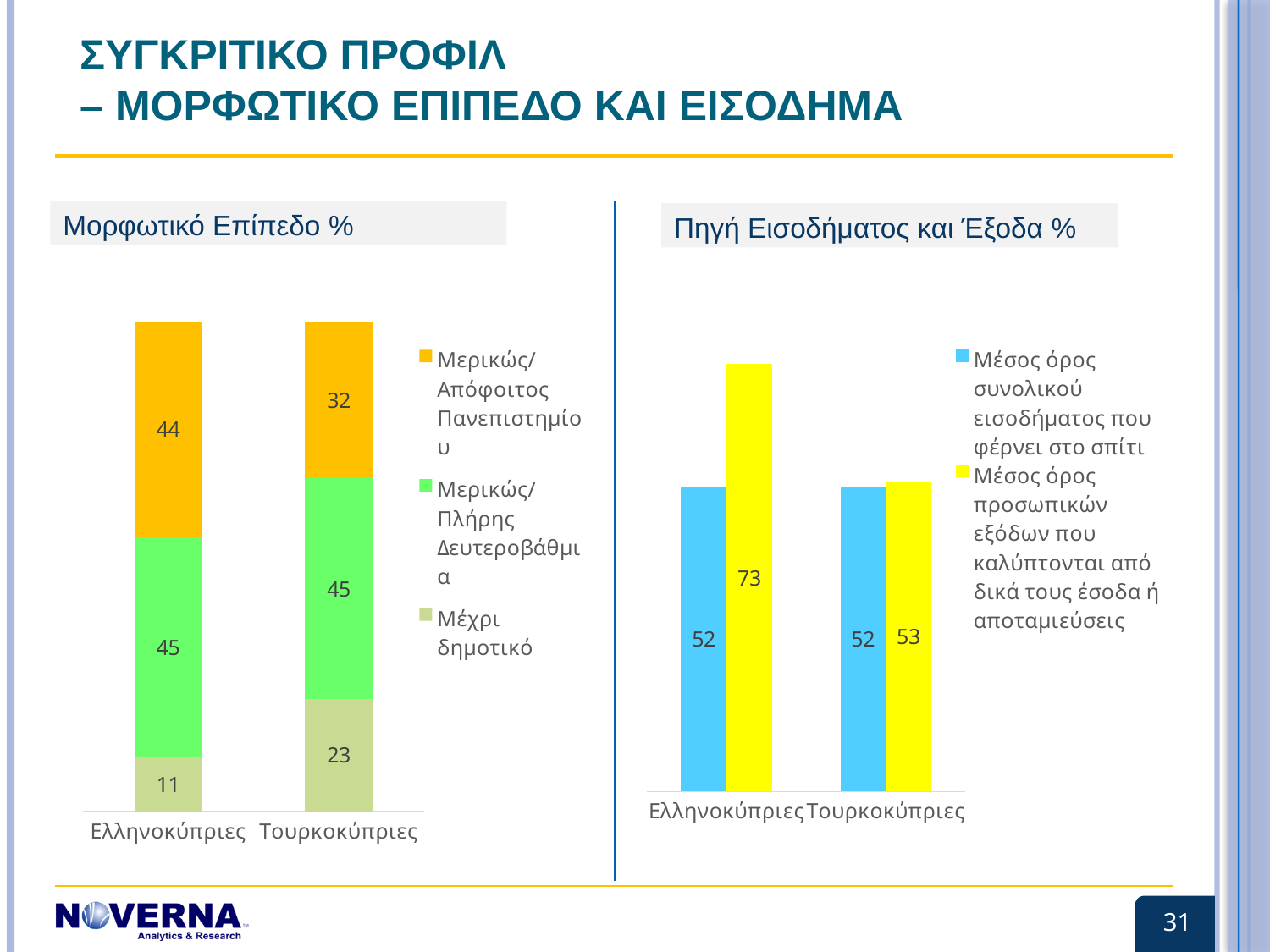
In the chart titled 'Μορφωτικό Επίπεδο %', what is the value for 'Μερικώς/Απόφοιτος Πανεπιστημίου' for Τουρκοκύπριες? 32 How many categories are shown on the x axis of the chart titled 'Πηγή Εισοδήματος και Έξοδα %'? 2 In the chart titled 'Μορφωτικό Επίπεδο %', which group has the larger 'Μερικώς/Απόφοιτος Πανεπιστημίου' value, Ελληνοκύπριες or Τουρκοκύπριες? Ελληνοκύπριες In the chart titled 'Πηγή Εισοδήματος και Έξοδα %', what is the value of 'Μέσος όρος προσωπικών εξόδων που καλύπτονται από δικά τους έσοδα ή αποταμιεύσεις' for Ελληνοκύπριες? 73 In the chart titled 'Πηγή Εισοδήματος και Έξοδα %', which bar is the highest? Ελληνοκύπριες, Μέσος όρος προσωπικών εξόδων (73) In the chart titled 'Πηγή Εισοδήματος και Έξοδα %', what is the difference between the two values for Ελληνοκύπριες? 21 In the chart titled 'Μορφωτικό Επίπεδο %', what is the total of the stacked bar for Ελληνοκύπριες? 100 In the chart titled 'Μορφωτικό Επίπεδο %', how many series does the legend list? 3 In the chart titled 'Πηγή Εισοδήματος και Έξοδα %', what is the value of 'Μέσος όρος συνολικού εισοδήματος που φέρνει στο σπίτι' for Τουρκοκύπριες? 52 What kind of chart is the chart titled 'Μορφωτικό Επίπεδο %'? Stacked bar chart In the chart titled 'Μορφωτικό Επίπεδο %', what is the value for 'Μέχρι δημοτικό' for Ελληνοκύπριες? 11 In the chart titled 'Μορφωτικό Επίπεδο %', what is the difference between the 'Μέχρι δημοτικό' values for Τουρκοκύπριες and Ελληνοκύπριες? 12